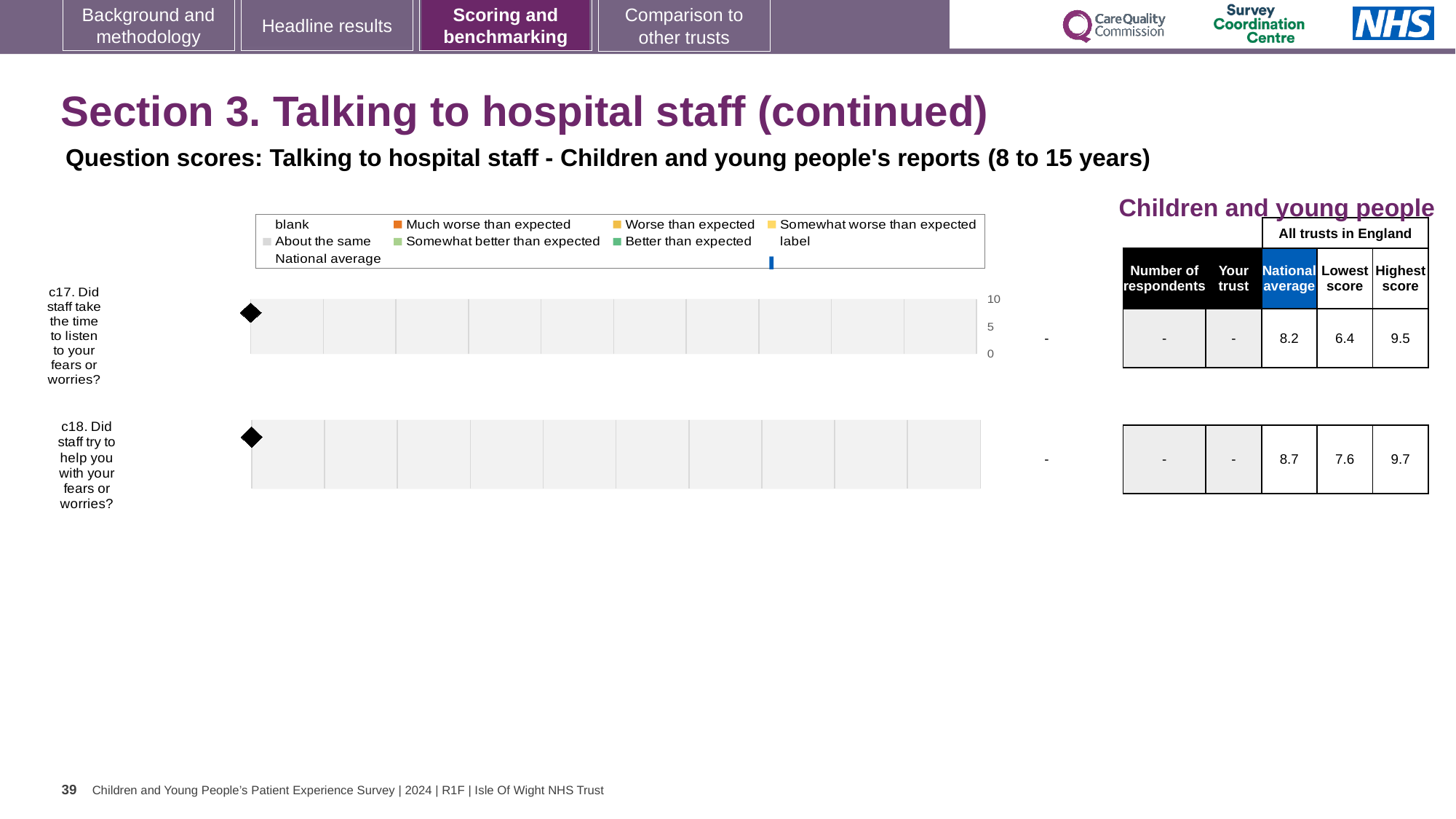
What colour does the legend use for 'Better than expected'? green What kind of chart is used for the c17 and c18 question scores? bar chart For c17, what is the Lowest score among all trusts in England? 6.4 For c18, what is the Lowest score among all trusts in England? 7.6 For c18, what is the Highest score among all trusts in England? 9.7 For c17, what is the difference between the Highest score and the Lowest score? 3.1 Which question has the higher National average score, c17 or c18? c18 For c17 (Did staff take the time to listen to your fears or worries?), what is the National average score? 8.2 How many survey questions (categories) are plotted on the slide? 2 For c18 (Did staff try to help you with your fears or worries?), what is the National average score? 8.7 For c17, what is the Highest score among all trusts in England? 9.5 What is the highest value shown on the score axis of the c17 chart? 10